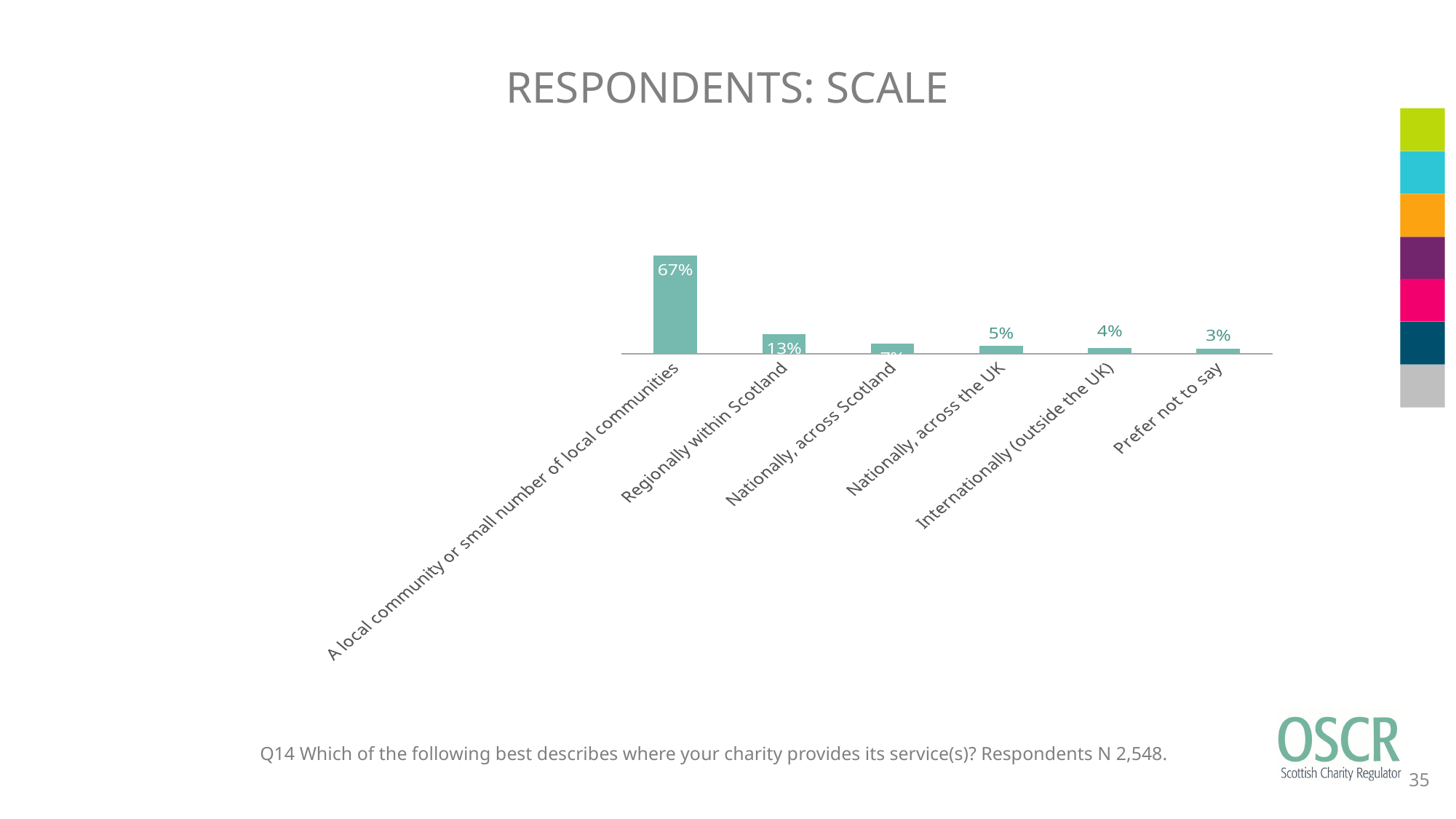
What is the value for 'Prefer not to say'? 3% What type of chart is shown on the slide? Bar chart What is the value for 'Internationally (outside the UK)'? 4% Do the values rise or fall from left to right across the categories? Fall What percentage of respondents said their charity provides services to a local community or small number of local communities? 67% What is the difference between the values for 'A local community or small number of local communities' and 'Regionally within Scotland'? 54 percentage points Which category has the highest value? A local community or small number of local communities What is the value for 'Regionally within Scotland'? 13% How many categories are shown in the chart? 6 Which category has the lowest value? Prefer not to say Which is larger: the value for 'Nationally, across the UK' or 'Internationally (outside the UK)'? Nationally, across the UK What is the value for 'Nationally, across the UK'? 5%